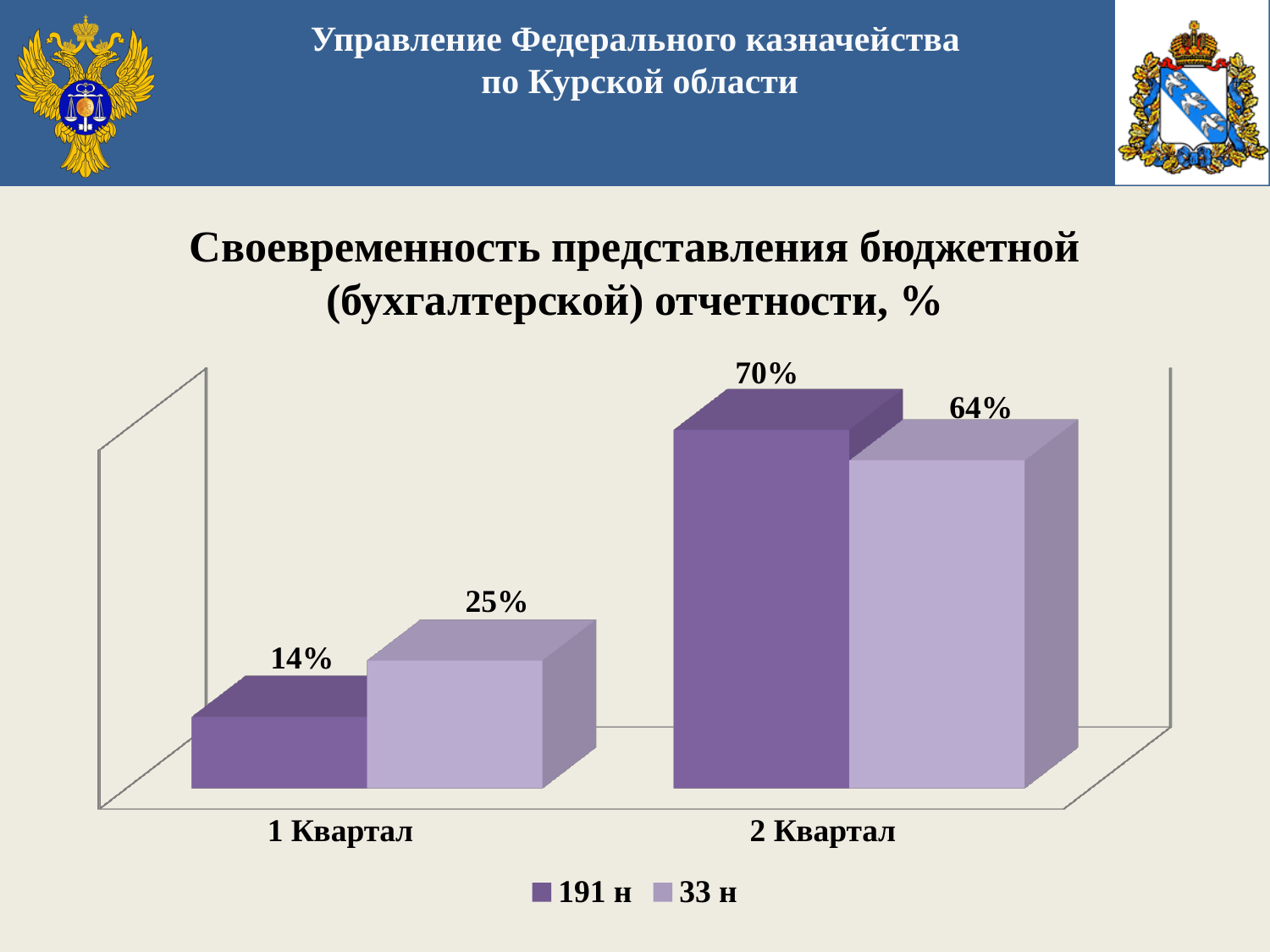
How many series does the legend list? 2 What is the value for 191 н in 2 Квартал? 70% What kind of chart is shown on the slide? Bar chart What is the difference between the 33 н and 191 н values in 1 Квартал? 11% Which category has the highest value for the 191 н series? 2 Квартал What is the difference between the 191 н and 33 н values in 2 Квартал? 6% What is the value for 191 н in 1 Квартал? 14% What is the value for 33 н in 2 Квартал? 64% How many categories are shown on the x axis? 2 In 1 Квартал, which series has the larger value, 191 н or 33 н? 33 н Which category has the lowest value for the 33 н series? 1 Квартал What is the value for 33 н in 1 Квартал? 25%